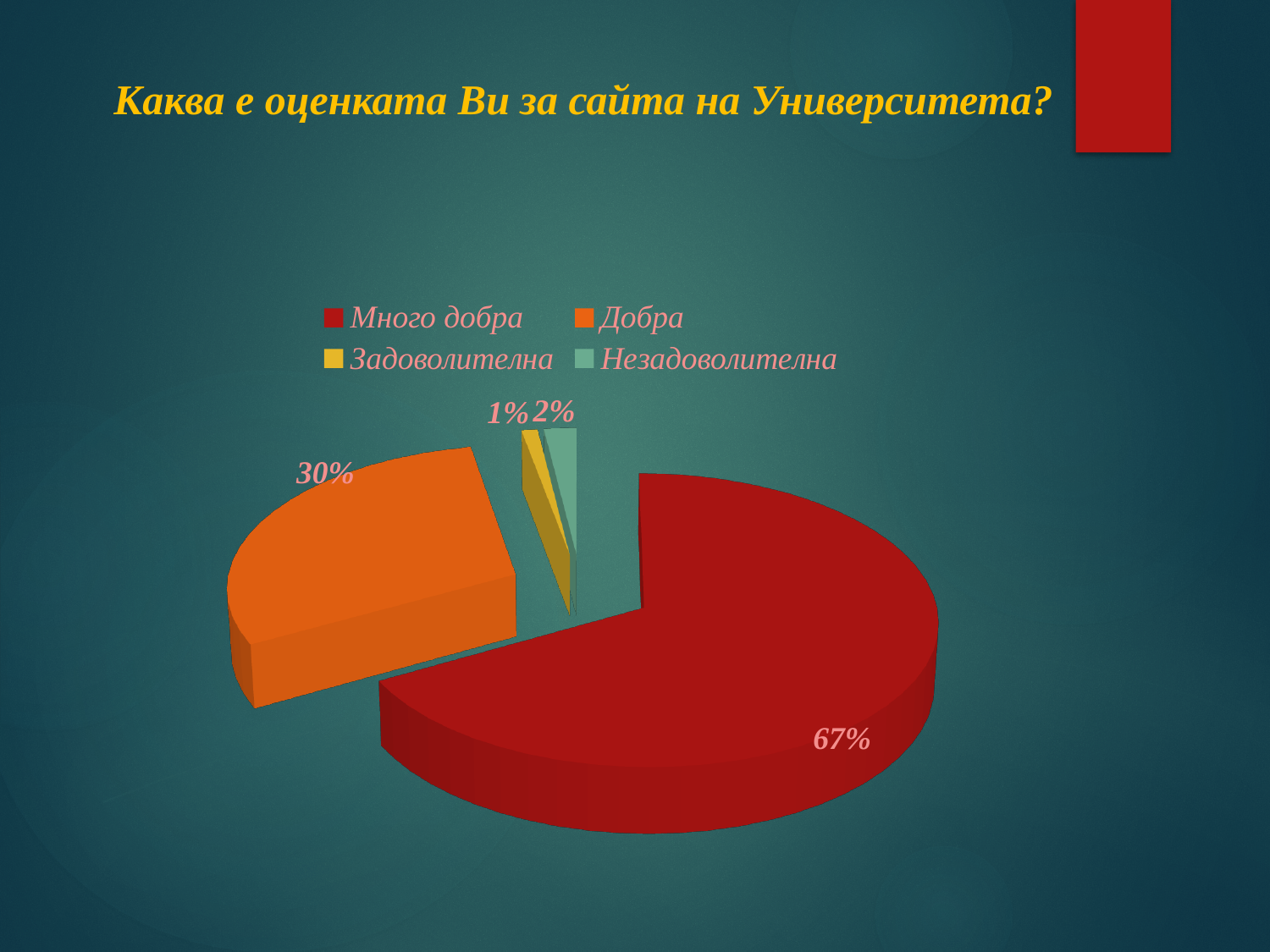
What share of the pie is labelled for Задоволителна? 1% What share of the pie is labelled for Много добра? 67% Which category has the smallest slice of the pie? Задоволителна What is the title of the chart on the slide? Каква е оценката Ви за сайта на Университета? Which is larger, the share for Добра or the share for Незадоволителна? Добра Which category has the largest slice of the pie? Много добра What is the difference in percentage points between Много добра and Добра? 37% What kind of chart is shown on the slide? pie chart What share of the pie is labelled for Добра? 30% How many entries does the legend list? 4 How many slices does the pie chart have? 4